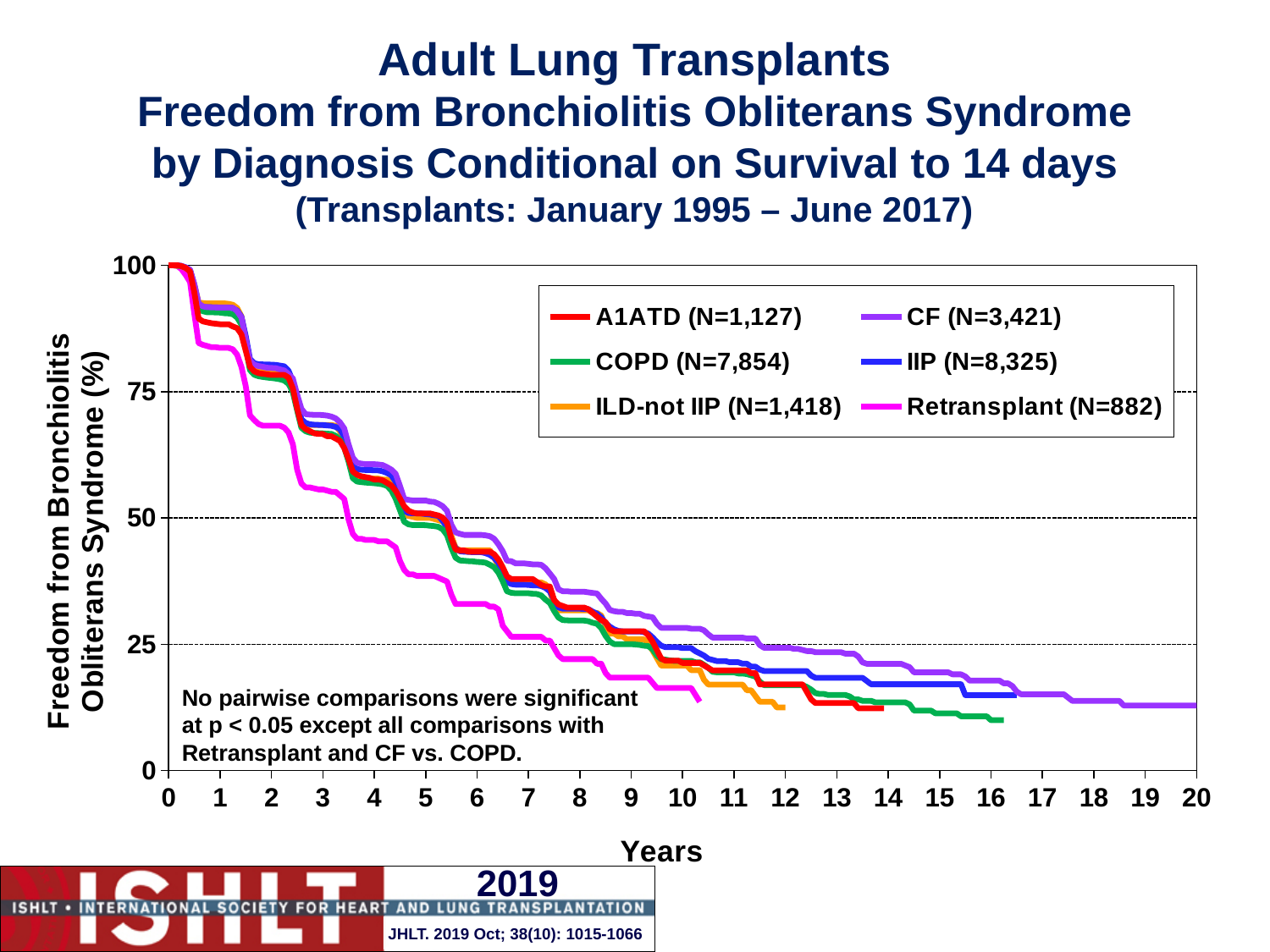
At year 10, which is larger: the value for CF or the value for Retransplant? CF How many series does the legend list? 6 What is the N shown in the legend for COPD? 7,854 Which series has the lowest freedom from Bronchiolitis Obliterans Syndrome at year 5? Retransplant (N=882) Is the value for COPD at year 15 greater or less than 25? less What is the value for all series at year 0? 100 Do the values for the series rise or fall as years increase along the x axis? fall Is the value for CF at year 8 greater or less than 25? greater Is the value for Retransplant at year 5 greater or less than 50? less What kind of chart is shown on the slide? line chart Which series extends furthest along the x axis, reaching 20 years? CF (N=3,421)